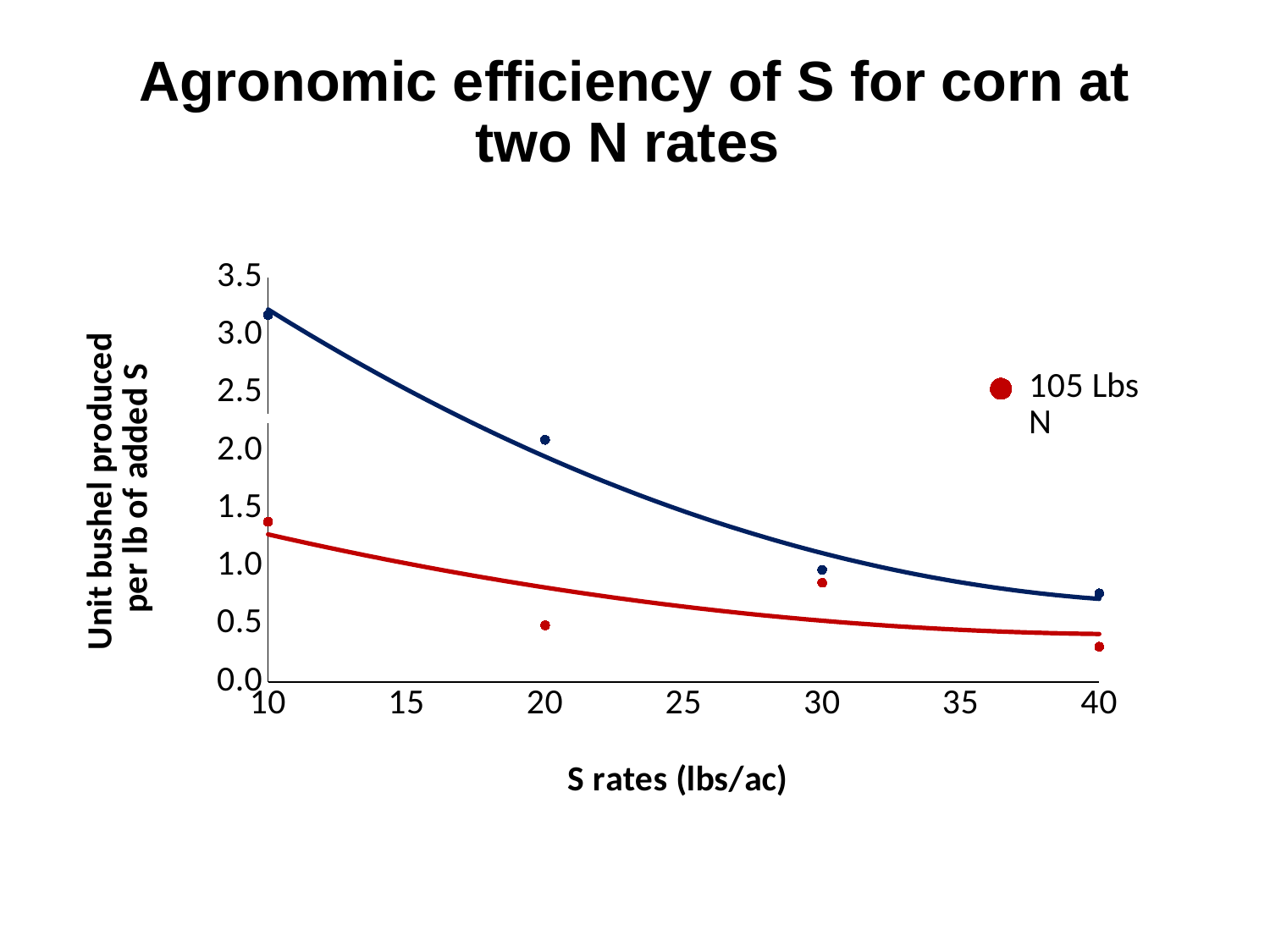
Is the value of the blue series at an S rate of 20 greater or less than 2.0? greater How many series does the legend list? 1 How many data points are plotted for the 105 Lbs N series? 4 What kind of chart is shown on the slide? scatter chart Do the values of the blue series rise or fall as the S rate increases? fall Is the value of the 105 Lbs N series at an S rate of 40 greater or less than 0.5? less Is the value of the 105 Lbs N series at an S rate of 10 greater or less than 1.0? greater What is the title of the chart? Agronomic efficiency of S for corn at two N rates At an S rate of 10, which series has the larger value, the blue series or the 105 Lbs N series? the blue series What is the label of the x axis? S rates (lbs/ac)